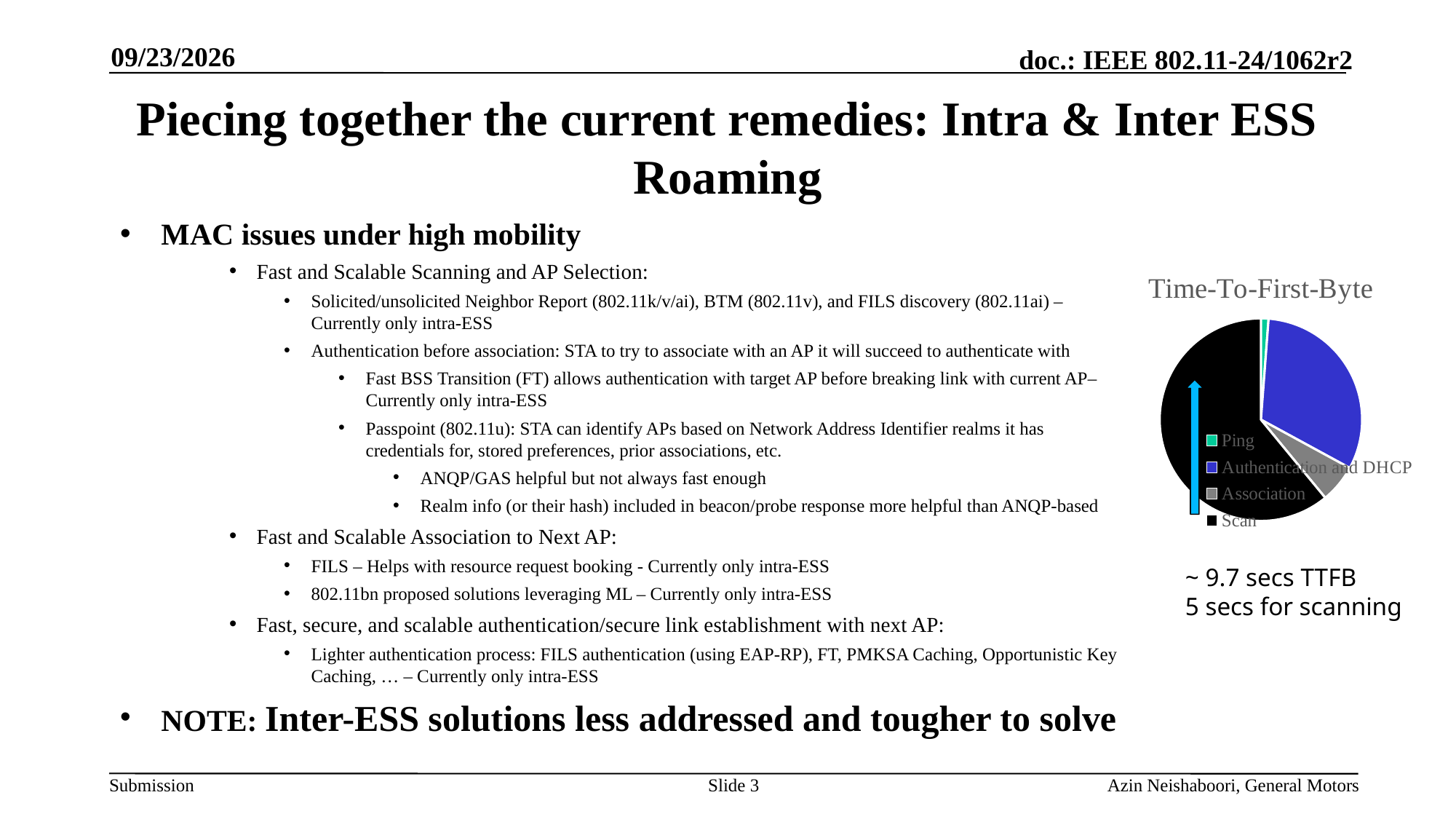
In the Time-To-First-Byte pie chart, which slice is larger: Scan or Authentication and DHCP? Scan Which category has the largest slice in the Time-To-First-Byte pie chart? Scan In the Time-To-First-Byte pie chart, which slice is larger: Association or Ping? Association Does the Scan slice take up more or less than half of the Time-To-First-Byte pie chart? more What is the title of the pie chart? Time-To-First-Byte In the Time-To-First-Byte pie chart, which slice is larger: Authentication and DHCP or Association? Authentication and DHCP Which category has the smallest slice in the Time-To-First-Byte pie chart? Ping How many categories does the legend of the Time-To-First-Byte pie chart list? 4 What kind of chart is shown on the slide? pie chart What colour is the Scan slice in the Time-To-First-Byte pie chart? black